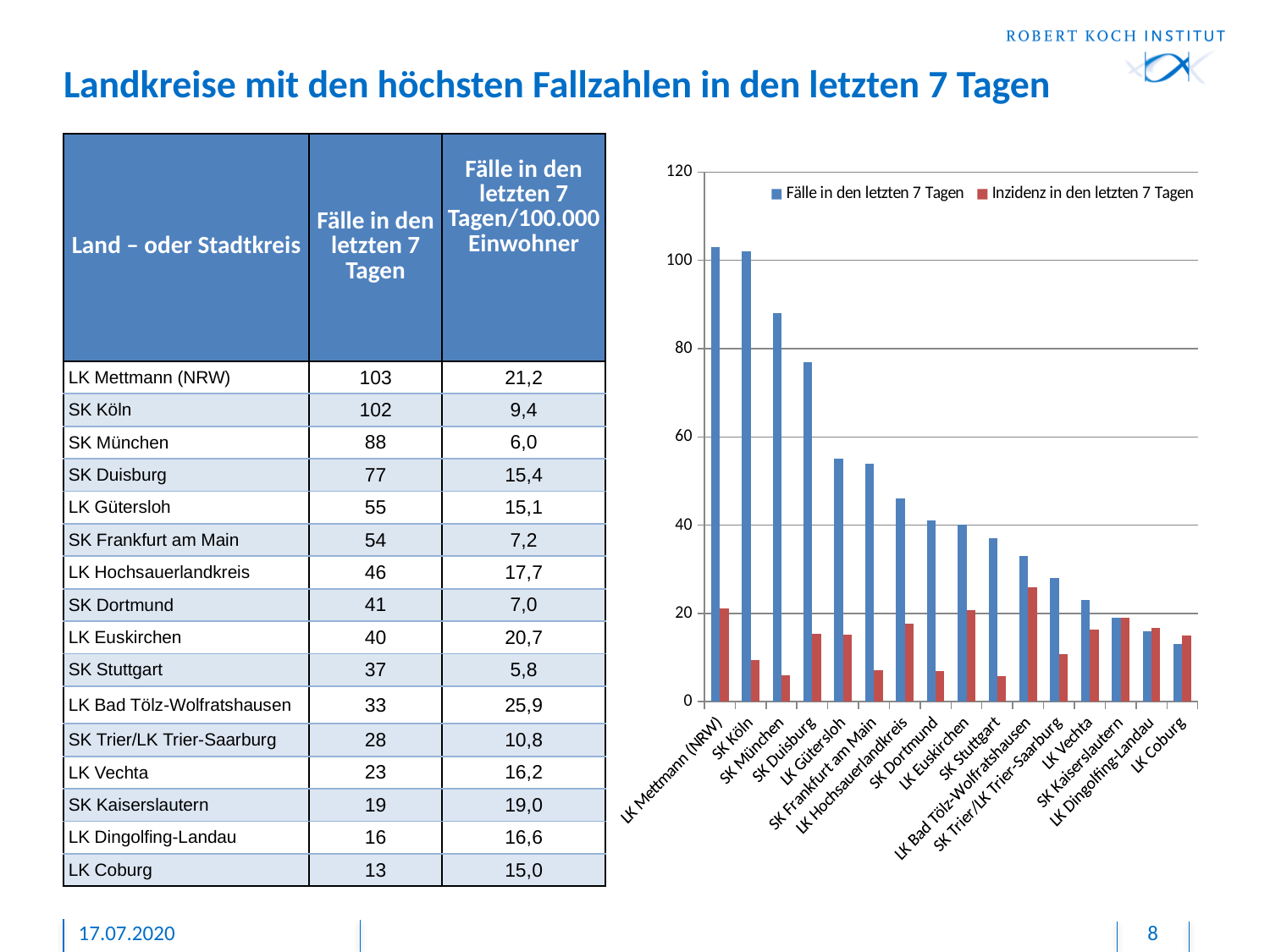
Which Landkreis or Stadtkreis has the highest number of Fälle in den letzten 7 Tagen? LK Mettmann (NRW) Do the blue bars (Fälle in den letzten 7 Tagen) rise or fall from left to right along the x axis? fall How many Landkreise/Stadtkreise are shown on the x axis of the chart? 16 What kind of chart is shown on the slide? bar chart What is the value of Fälle in den letzten 7 Tagen for SK München? 88 What is the difference in Fälle in den letzten 7 Tagen between LK Mettmann (NRW) and SK Köln? 1 Is the value of Fälle in den letzten 7 Tagen for SK Köln greater or less than 100? greater What is the Inzidenz in den letzten 7 Tagen for LK Bad Tölz-Wolfratshausen? 25,9 Which is larger: Fälle in den letzten 7 Tagen for LK Gütersloh or for LK Euskirchen? LK Gütersloh Is the value of Fälle in den letzten 7 Tagen for SK Duisburg greater or less than 80? less How many series does the chart legend list? 2 Which Landkreis or Stadtkreis has the lowest number of Fälle in den letzten 7 Tagen? LK Coburg